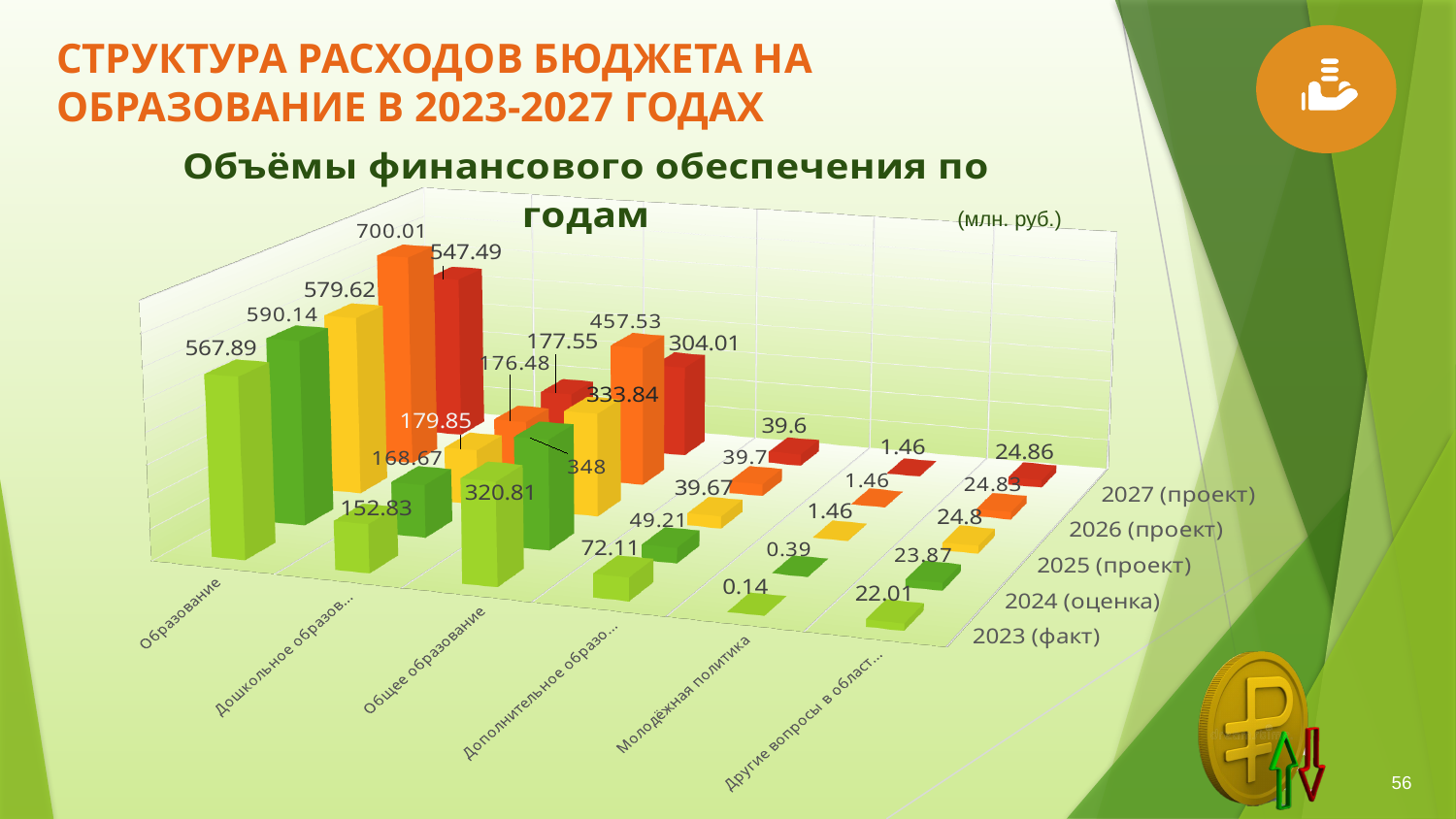
How many year series does the chart show? 5 What is the value for Образование in 2023 (факт)? 567.89 In which year is the value for Образование the highest? 2026 (проект) How many categories are shown along the horizontal axis? 6 What is the value for Молодёжная политика in 2023 (факт)? 0.14 What is the value for Общее образование in 2026 (проект)? 457.53 What is the value for Образование in 2026 (проект)? 700.01 What is the difference between the Образование values for 2026 (проект) and 2027 (проект)? 152.52 What kind of chart is shown on the slide? bar chart Which is larger in 2023 (факт): Образование or Общее образование? Образование In which year is the value for Молодёжная политика the lowest? 2023 (факт) What unit of measurement is indicated on the chart? млн. руб.